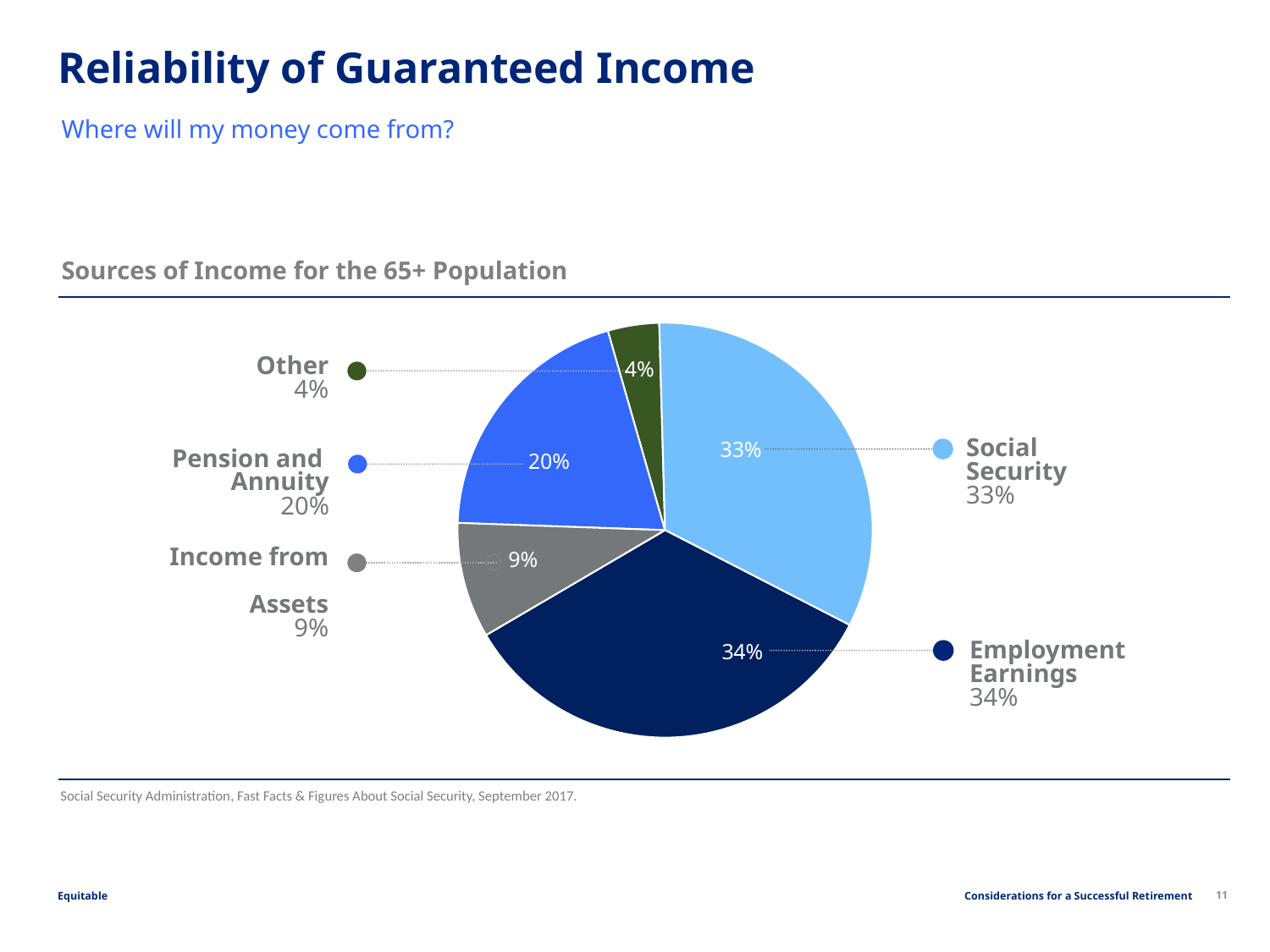
What is the title of the chart? Sources of Income for the 65+ Population Which is larger, the share for Pension and Annuity or the share for Income from Assets? Pension and Annuity What kind of chart is shown on the slide? Pie chart What share of income for the 65+ population comes from Income from Assets? 9% How many income sources are shown in the pie chart? 5 What share of income for the 65+ population comes from Social Security? 33% What share of income for the 65+ population comes from Employment Earnings? 34% What share of income for the 65+ population comes from Pension and Annuity? 20% What is the difference in percentage points between Pension and Annuity and Income from Assets? 11 Which source of income has the smallest share of the pie? Other What share of income for the 65+ population comes from Other sources? 4% What is the difference in percentage points between Social Security and Other? 29